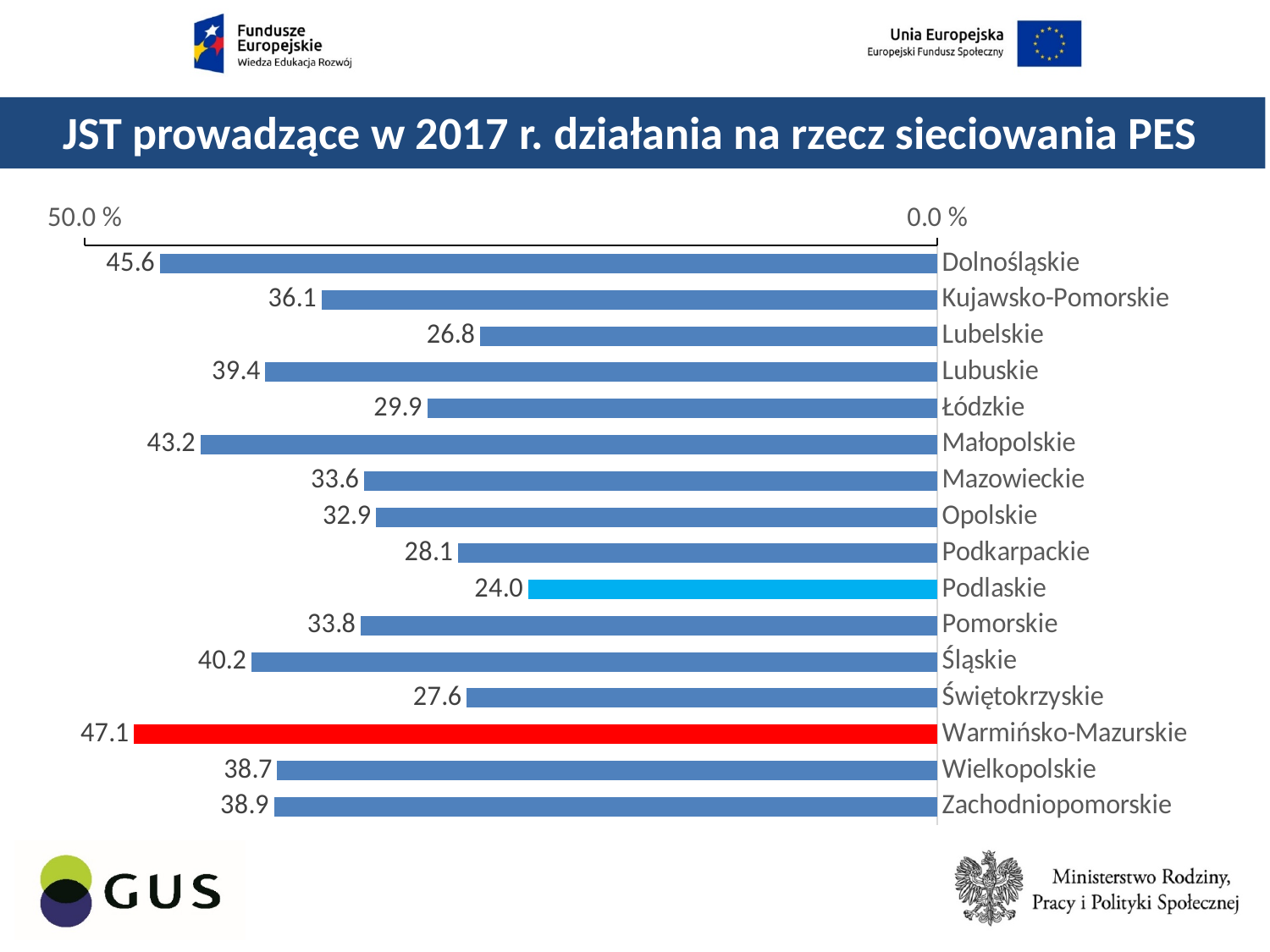
Which has a larger value, Mazowieckie or Opolskie? Mazowieckie What is the value for Dolnośląskie? 45.6 What is the value for Podlaskie? 24.0 Which has a larger value, Śląskie or Lubuskie? Śląskie Which bar is coloured red? Warmińsko-Mazurskie What is the value for Świętokrzyskie? 27.6 What kind of chart is shown on the slide? bar chart What is the difference between the values for Warmińsko-Mazurskie and Podlaskie? 23.1 What is the difference between the values for Małopolskie and Lubelskie? 16.4 How many voivodeships are shown in the chart? 16 Which voivodeship has the highest value? Warmińsko-Mazurskie Which voivodeship has the lowest value? Podlaskie